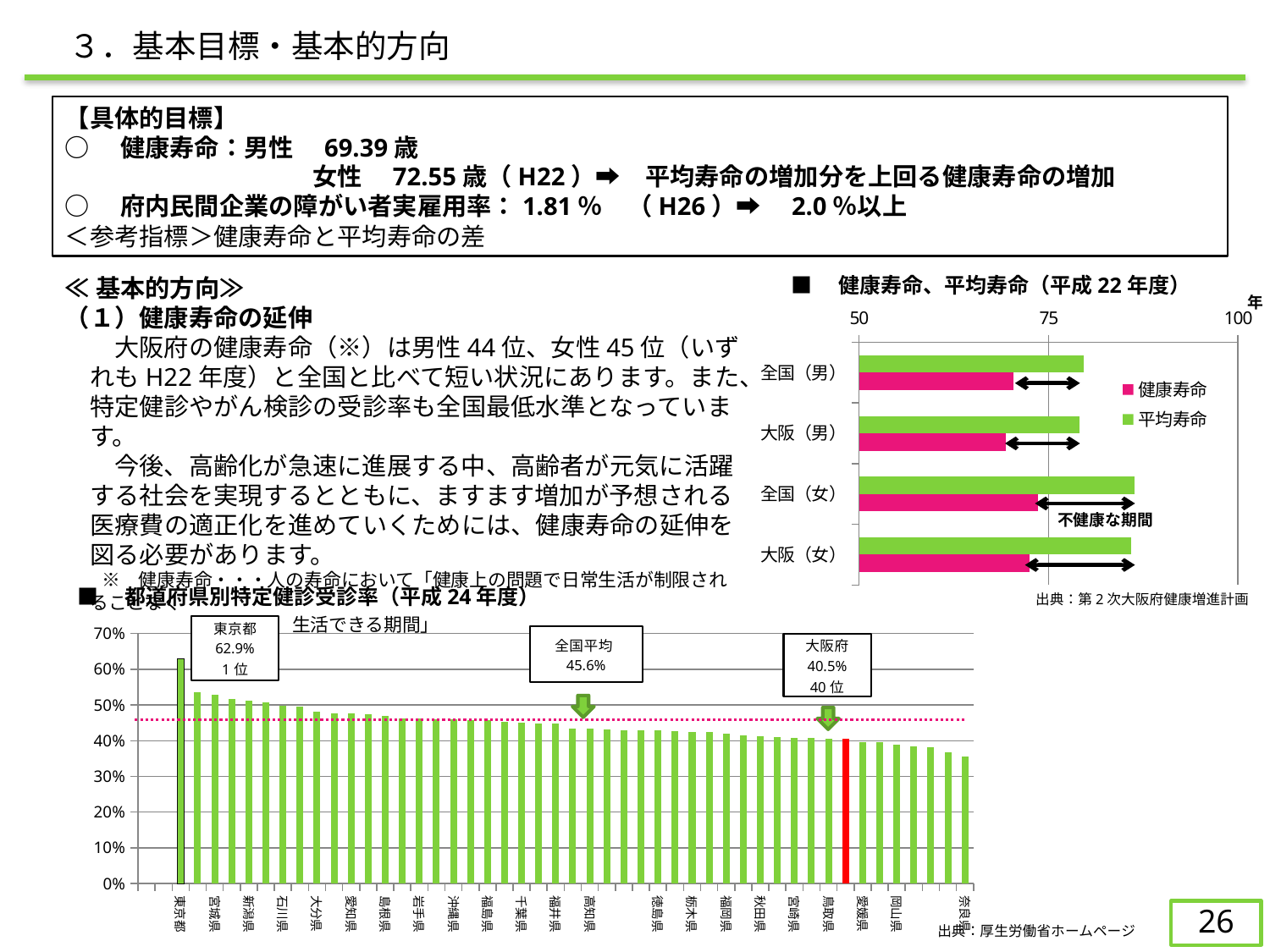
In the top-right chart (健康寿命、平均寿命), how many categories are shown on the vertical axis? 4 In the bottom chart (都道府県別特定健診受診率), which prefecture has the highest value? 東京都 In the top-right chart (健康寿命、平均寿命), how many series does the legend list? 2 In the bottom chart (都道府県別特定健診受診率), what is the value for 東京都? 62.9% In the bottom chart (都道府県別特定健診受診率), which prefecture's bar is drawn in red? 大阪府 In the bottom chart (都道府県別特定健診受診率), how much lower is 大阪府 than the 全国平均? 5.1 percentage points In the bottom chart (都道府県別特定健診受診率), what is the value for 大阪府? 40.5% In the bottom chart (都道府県別特定健診受診率), is the value for 奈良県 greater or less than 40%? less In the bottom chart (都道府県別特定健診受診率), what is the difference between the values for 東京都 and 大阪府? 22.4 percentage points In the bottom chart (都道府県別特定健診受診率), what is the 全国平均 value shown? 45.6% In the top-right chart (健康寿命、平均寿命), is the 平均寿命 value for 全国（男） greater or less than 75? greater In the bottom chart (都道府県別特定健診受診率), do the values rise or fall from left to right along the x axis? fall